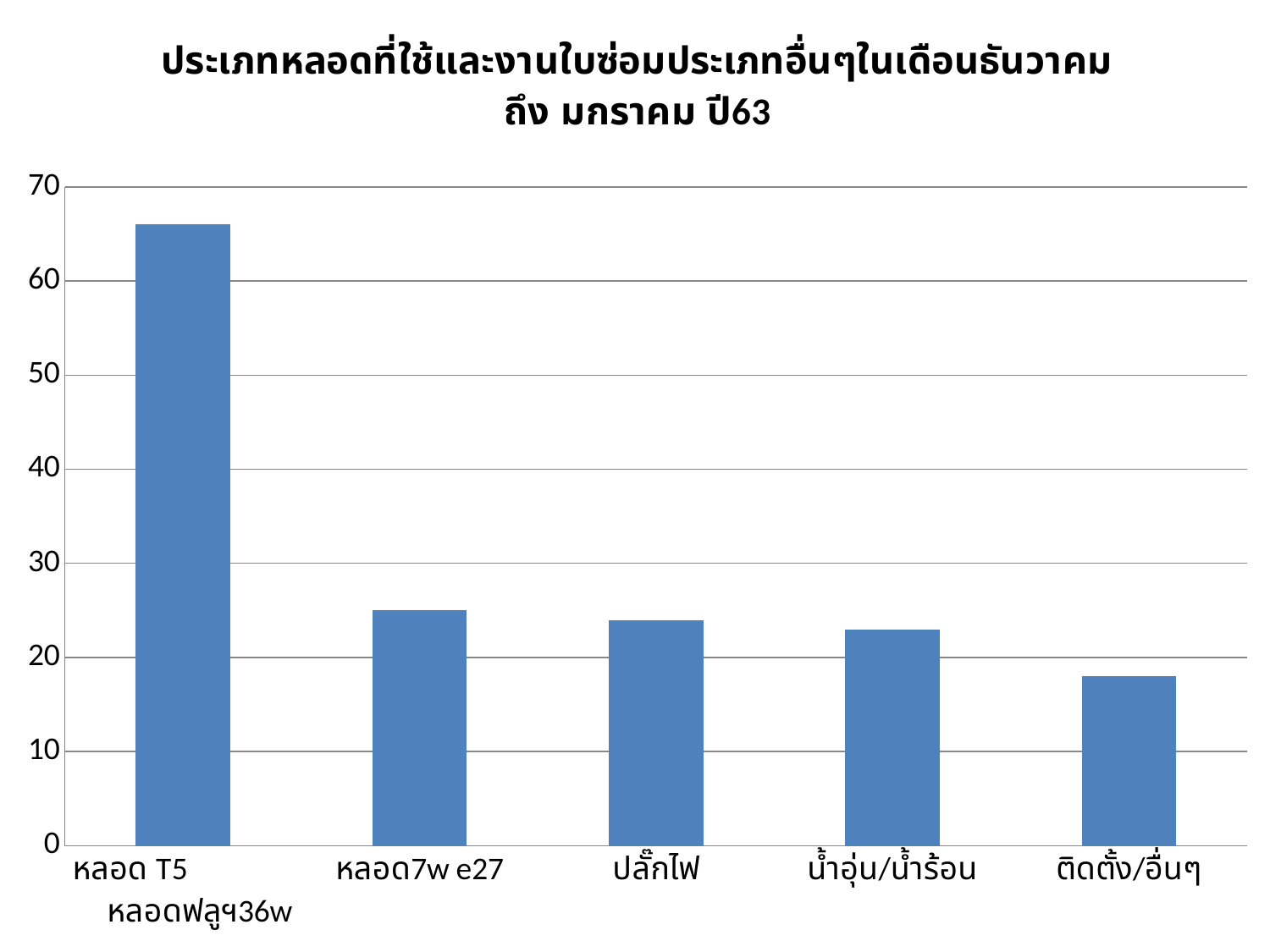
Which category has the highest value? หลอด T5 หลอดฟลูฯ36w Which is larger, the value for น้ำอุ่น/น้ำร้อน or the value for ติดตั้ง/อื่นๆ? น้ำอุ่น/น้ำร้อน Is the value for ปลั๊กไฟ greater or less than 20? greater Is the value for หลอด7w e27 greater or less than 30? less Is the value for หลอด T5 หลอดฟลูฯ36w greater or less than 60? greater Which category has the lowest value? ติดตั้ง/อื่นๆ What kind of chart is shown on the slide? bar chart How many categories are plotted on the chart? 5 Do the values rise or fall from left to right across the categories? fall What is the highest value shown on the vertical axis? 70 Which is larger, the value for หลอด T5 หลอดฟลูฯ36w or the value for ติดตั้ง/อื่นๆ? หลอด T5 หลอดฟลูฯ36w